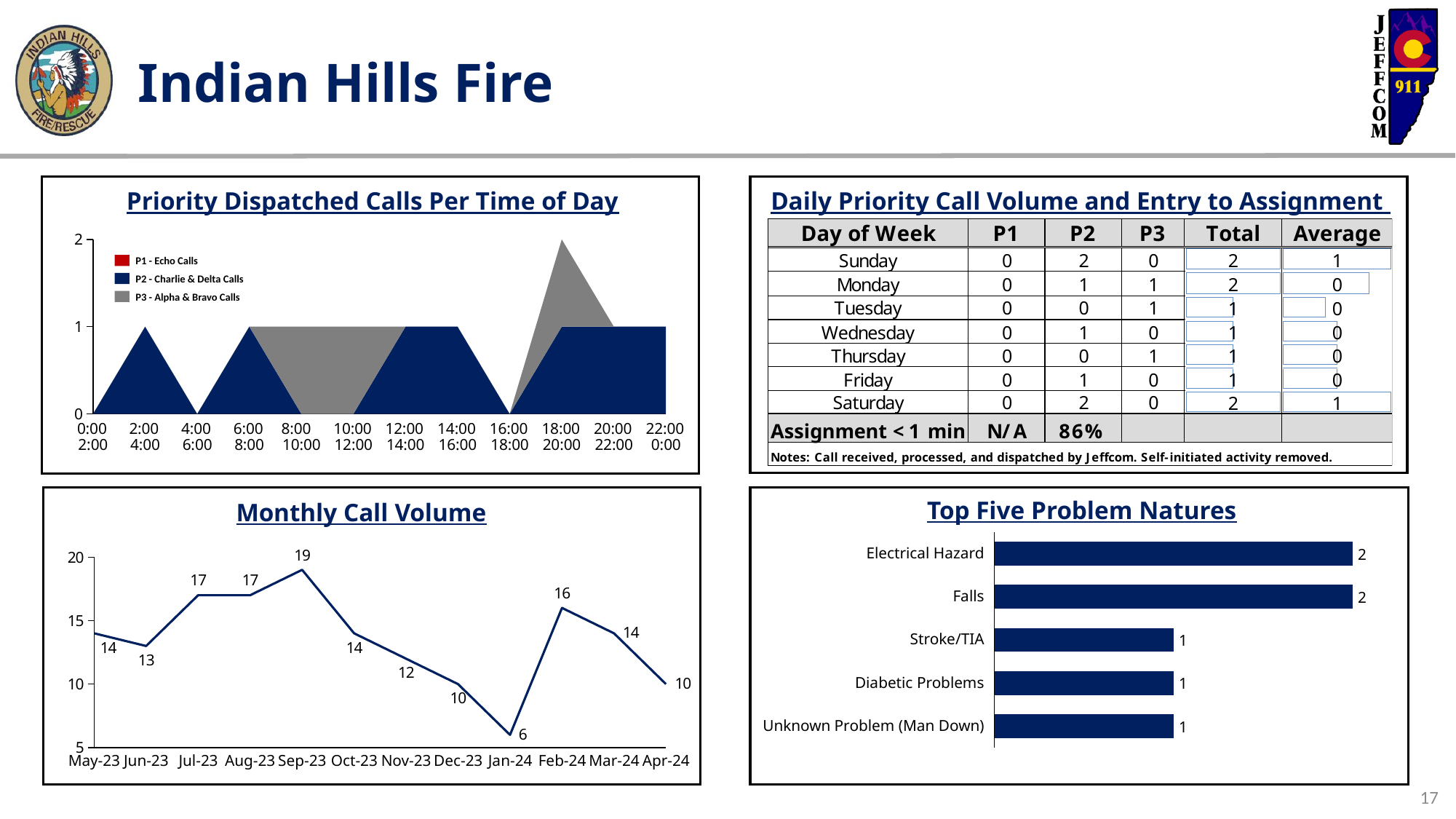
What kind of chart is the Top Five Problem Natures chart? bar chart On the Monthly Call Volume chart, what is the difference between the values for Feb-24 and Jan-24? 10 On the Top Five Problem Natures chart, what is the value for Falls? 2 On the Monthly Call Volume chart, which month has the highest call volume? Sep-23 On the Monthly Call Volume chart, how many months are plotted? 12 On the Monthly Call Volume chart, do the values rise or fall from Sep-23 to Jan-24? fall On the Priority Dispatched Calls Per Time of Day chart, how many series does the legend list? 3 On the Priority Dispatched Calls Per Time of Day chart, which time slot reaches the highest value? 18:00-20:00 On the Top Five Problem Natures chart, how many problem natures are listed? 5 On the Monthly Call Volume chart, what is the value for Sep-23? 19 On the Monthly Call Volume chart, which is larger, the value for Oct-23 or the value for Nov-23? Oct-23 On the Monthly Call Volume chart, which month has the lowest call volume? Jan-24